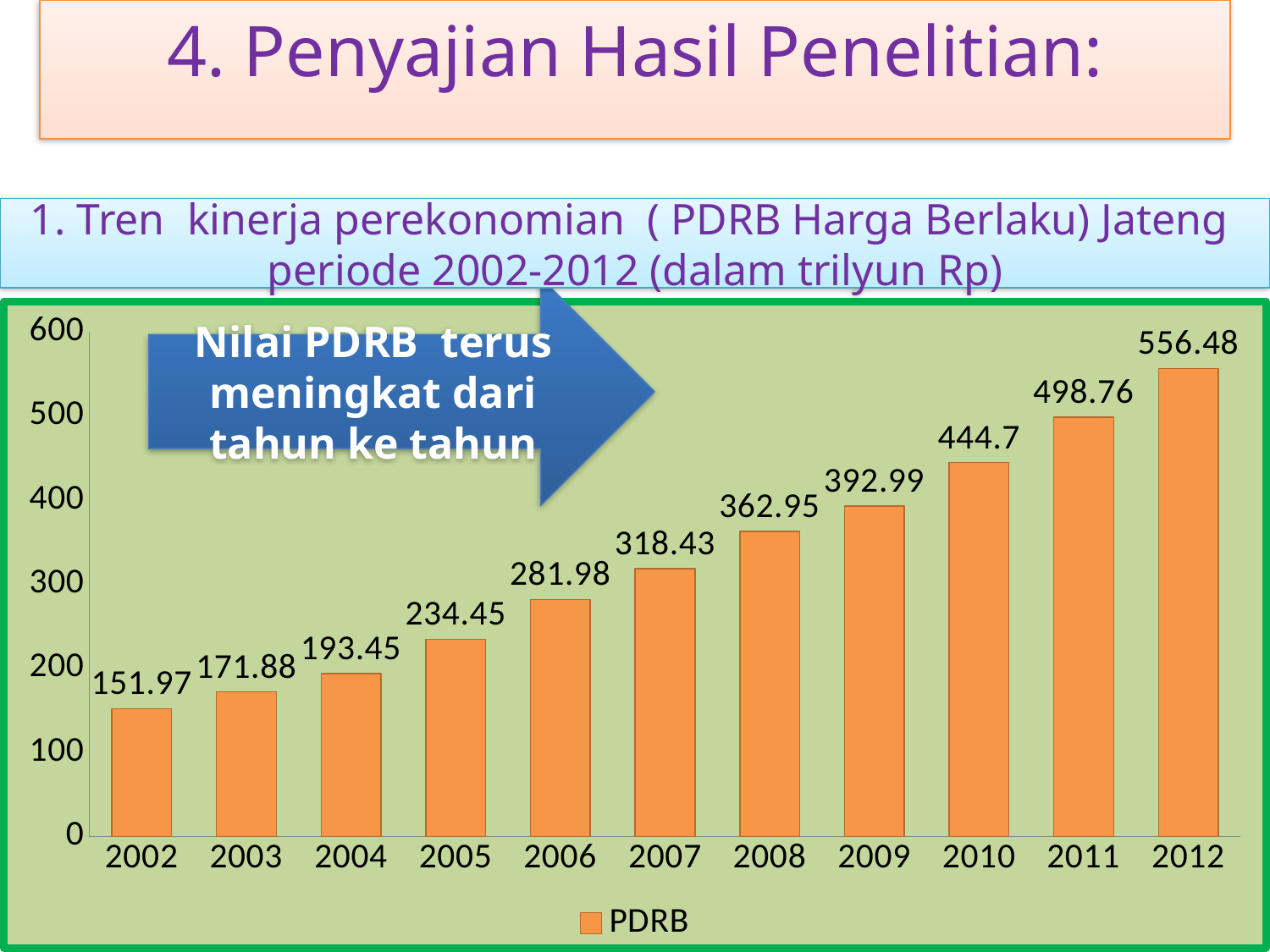
Is the PDRB value for 2010 greater or less than 400? greater Which year has a larger PDRB value, 2007 or 2009? 2009 Do the PDRB values rise or fall from 2002 to 2012? rise What is the difference between the PDRB values for 2006 and 2005? 47.53 Which year has the lowest PDRB value? 2002 How many years are shown on the x axis? 11 What is the difference between the PDRB values for 2012 and 2011? 57.72 What kind of chart is shown on the slide? bar chart Which year has the highest PDRB value? 2012 What is the PDRB value for 2012? 556.48 What is the PDRB value for 2008? 362.95 What is the PDRB value for 2002? 151.97